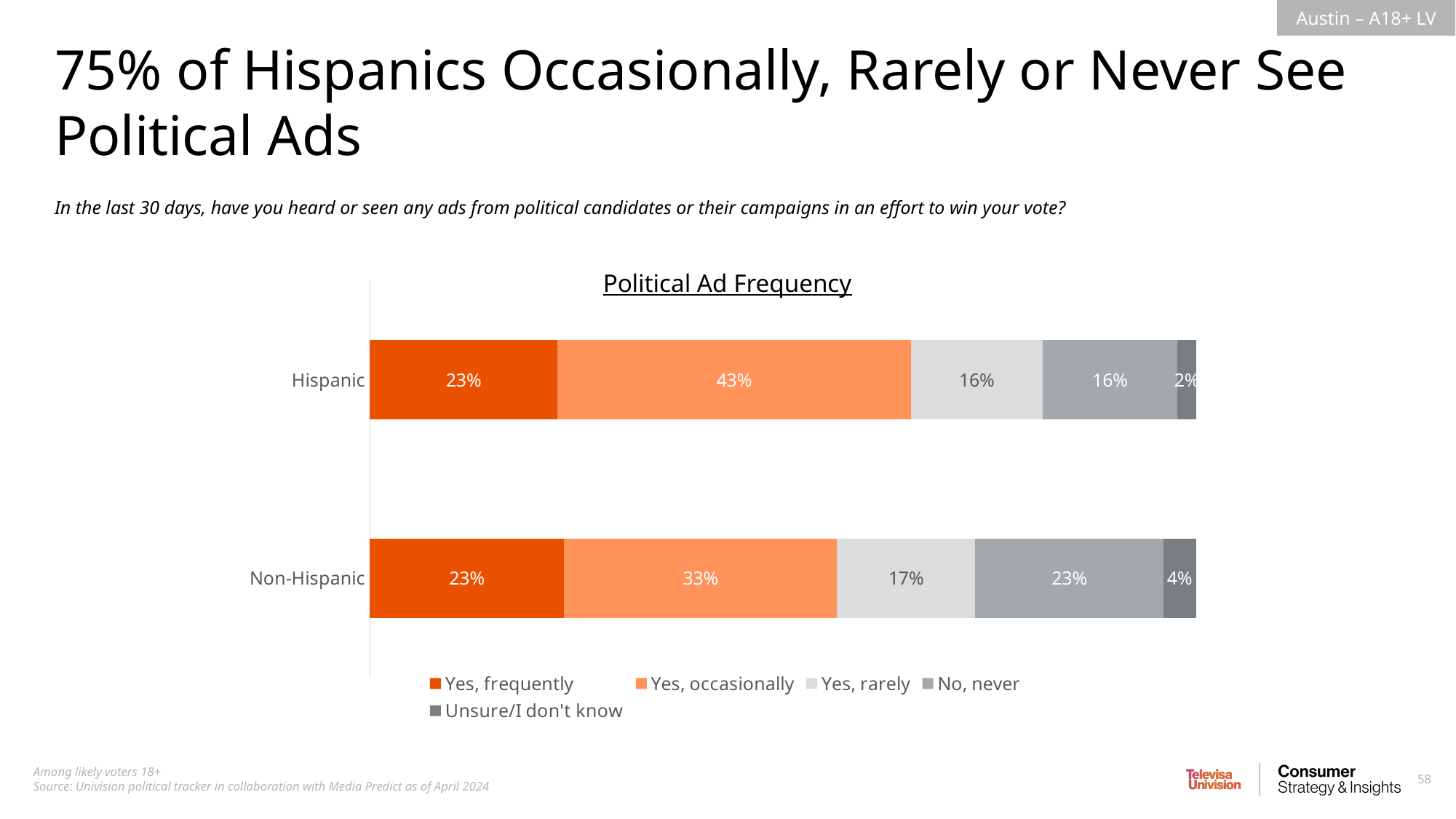
What type of chart is shown on the slide? Stacked bar chart Which response category has the smallest share among Non-Hispanic respondents? Unsure/I don't know What is the "Yes, rarely" value for Non-Hispanic respondents? 17% What is the difference between the "Yes, occasionally" values for Hispanic and Non-Hispanic respondents? 10 percentage points How many groups (bars) are shown in the chart? 2 How many series does the legend list? 5 What is the title of the chart? Political Ad Frequency What is the "Unsure/I don't know" value for Hispanic respondents? 2% What percentage of Hispanic respondents said they see political ads occasionally? 43% What percentage of Non-Hispanic respondents answered "No, never"? 23% Which group has a higher "No, never" value, Hispanic or Non-Hispanic? Non-Hispanic Which response category has the largest share among Hispanic respondents? Yes, occasionally